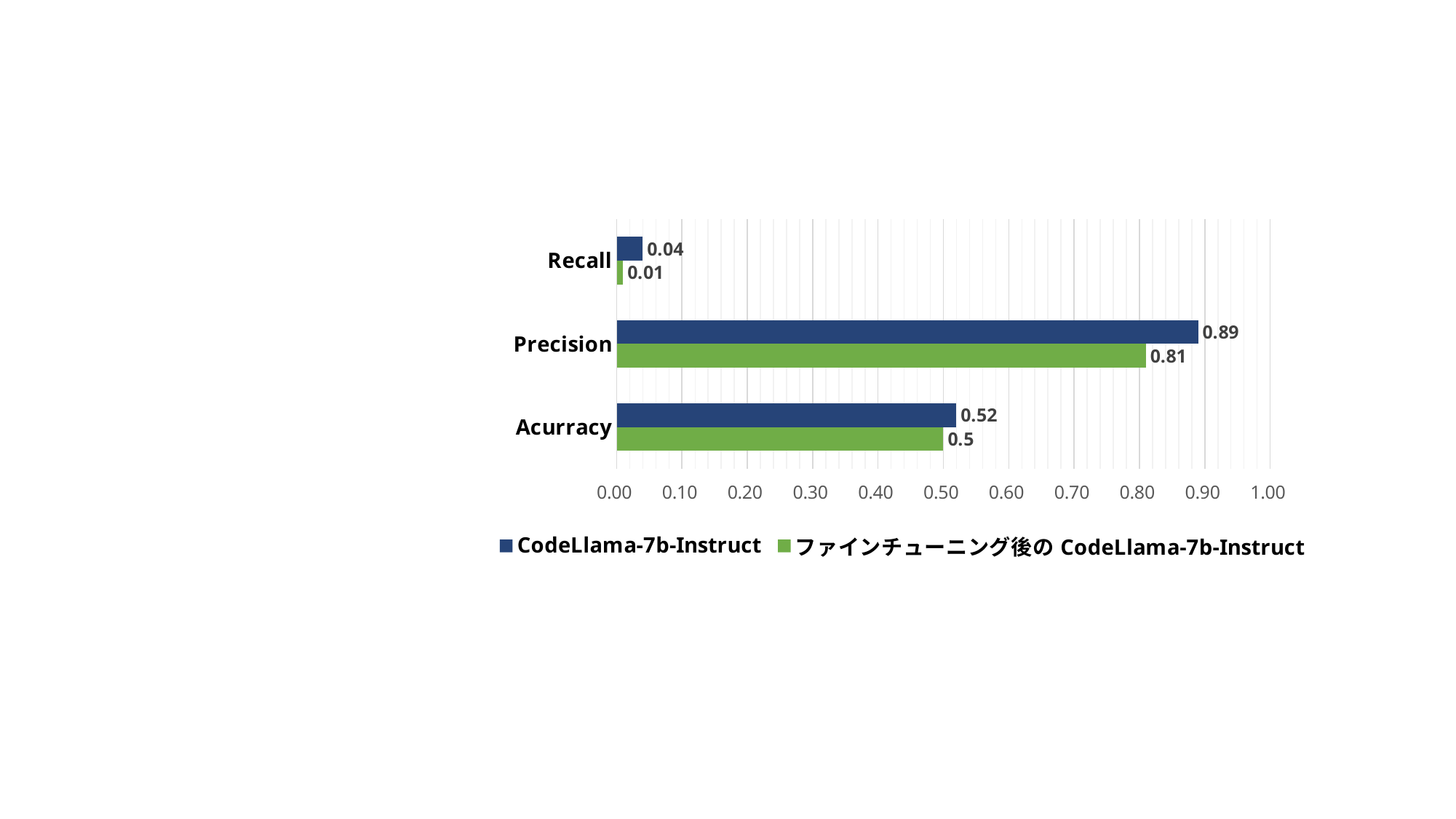
What is the Recall value for CodeLlama-7b-Instruct? 0.04 What is the Acurracy value for ファインチューニング後の CodeLlama-7b-Instruct? 0.5 Which category has the highest value for CodeLlama-7b-Instruct? Precision What is the difference between the Precision values of CodeLlama-7b-Instruct and ファインチューニング後の CodeLlama-7b-Instruct? 0.08 What kind of chart is shown on the slide? Bar chart What is the Recall value for ファインチューニング後の CodeLlama-7b-Instruct? 0.01 Which category has the lowest value for ファインチューニング後の CodeLlama-7b-Instruct? Recall How many categories are shown on the chart? 3 How many series does the legend list? 2 Is the Precision value for ファインチューニング後の CodeLlama-7b-Instruct greater or less than 0.70? greater What is the Precision value for CodeLlama-7b-Instruct? 0.89 Which series has the larger Acurracy value, CodeLlama-7b-Instruct or ファインチューニング後の CodeLlama-7b-Instruct? CodeLlama-7b-Instruct